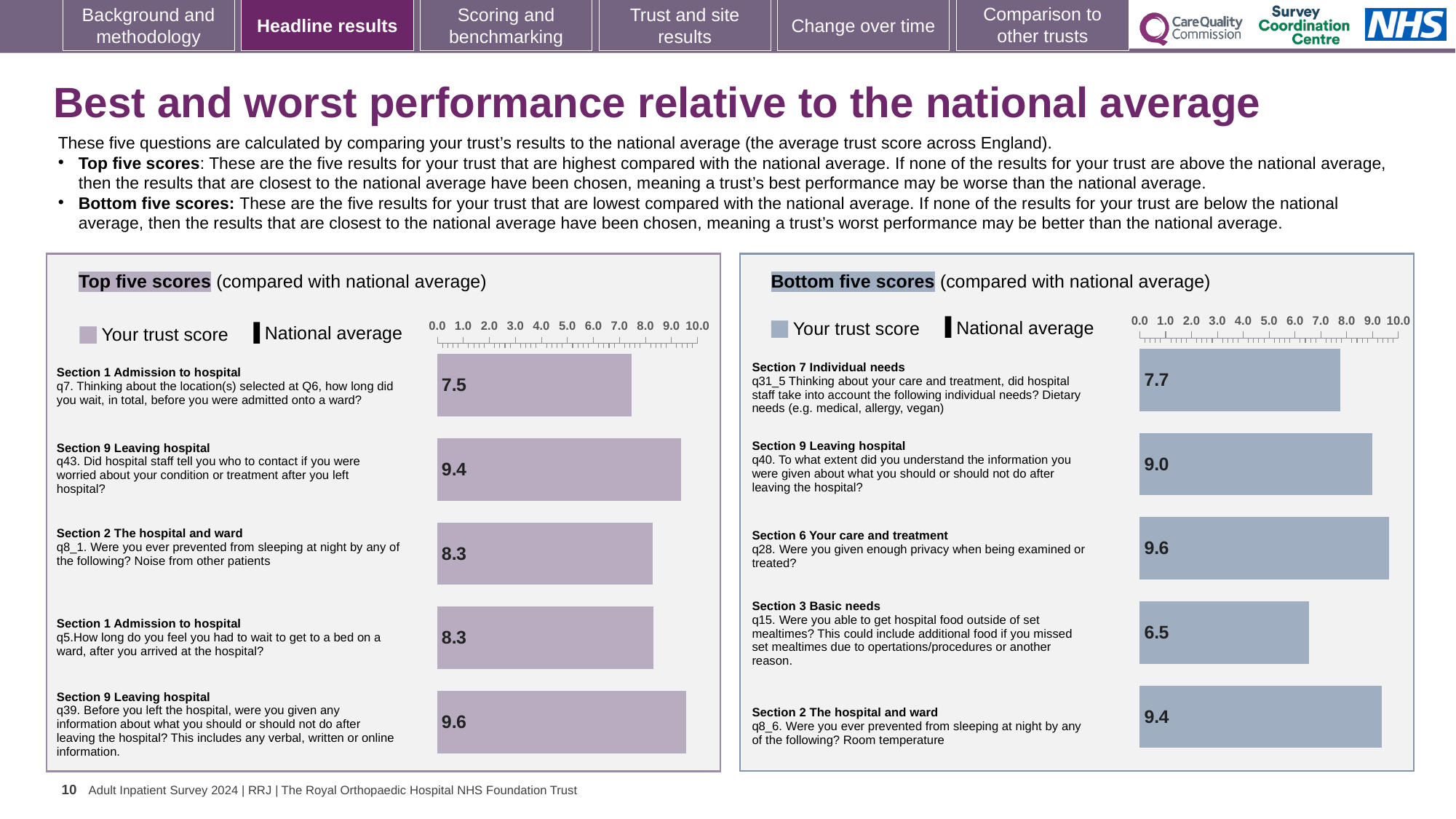
In the Bottom five scores chart, what is the difference between the trust scores for q28 and q15? 3.1 How many series does the legend of the Top five scores chart list? 2 How many bars are plotted in the Bottom five scores chart? 5 In the Top five scores chart, is the trust score for q43 greater or less than 9.0? greater In the Bottom five scores chart, which question has the lowest trust score? q15 (6.5) In the Top five scores chart, what is the difference between the trust scores for q39 and q7? 2.1 In the Bottom five scores chart, which has the larger trust score: q40 or q31_5? q40 What type of chart is used for the Top five scores? Bar chart In the Top five scores chart, what is the trust score for q7 (how long did you wait before being admitted onto a ward)? 7.5 In the Top five scores chart, what is the trust score for q8_1 (prevented from sleeping by noise from other patients)? 8.3 In the Bottom five scores chart, what is the trust score for q15 (able to get hospital food outside of set mealtimes)? 6.5 In the Top five scores chart, which question has the highest trust score? q39 (9.6)